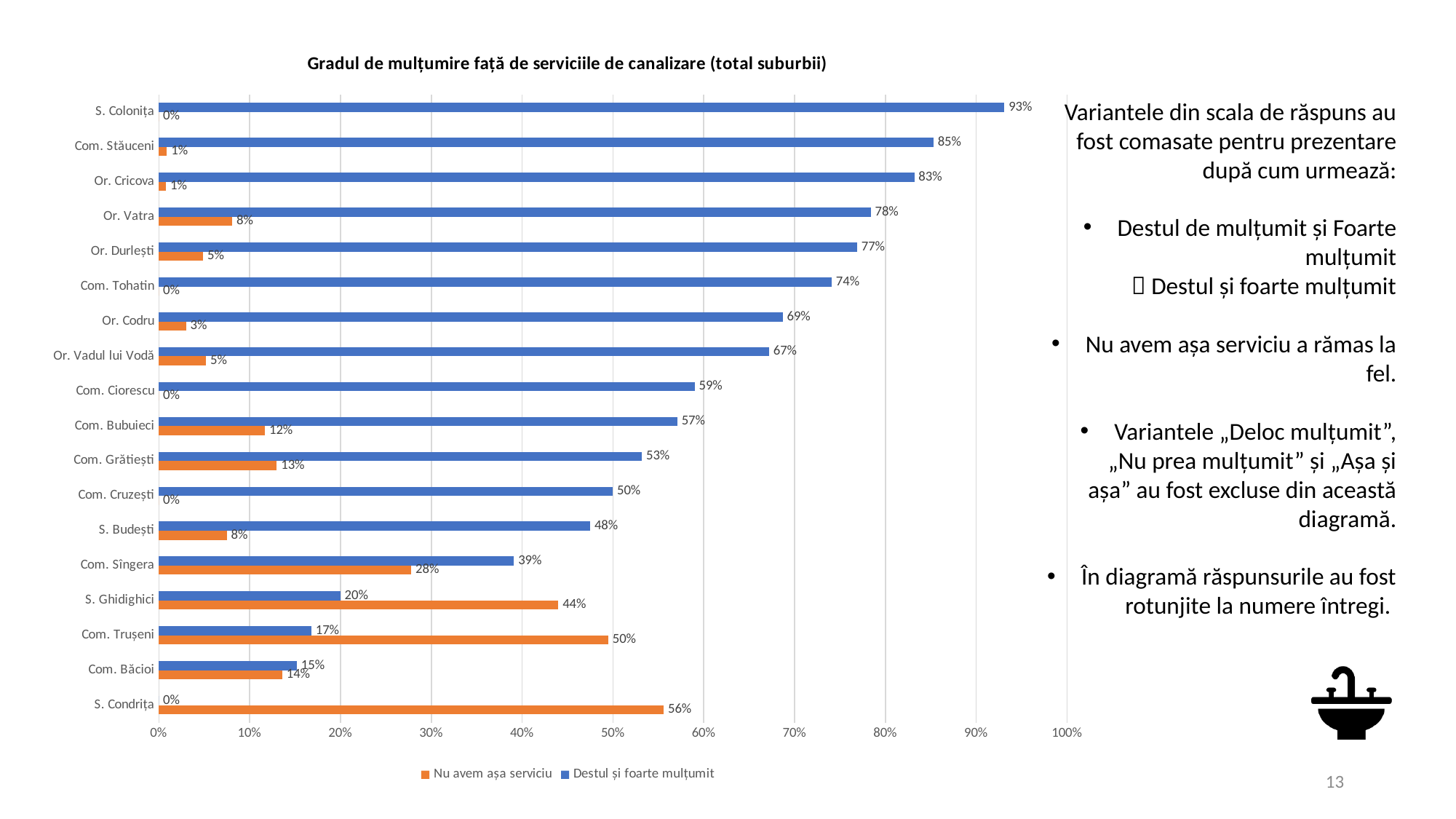
What is the value of "Destul și foarte mulțumit" for S. Colonița? 93% Which colour represents the series "Nu avem așa serviciu"? Orange How many series does the legend list? 2 What is the difference between the "Destul și foarte mulțumit" values for Com. Stăuceni and Or. Cricova? 2% Which category has the lowest value for "Destul și foarte mulțumit"? S. Condrița What is the title of the chart? Gradul de mulțumire față de serviciile de canalizare (total suburbii) Which category has the highest value for "Nu avem așa serviciu"? S. Condrița Which is larger for S. Ghidighici: "Nu avem așa serviciu" or "Destul și foarte mulțumit"? Nu avem așa serviciu What is the value of "Destul și foarte mulțumit" for Com. Sîngera? 39% What is the value of "Nu avem așa serviciu" for Com. Trușeni? 50% What kind of chart is shown on the slide? Bar chart How many categories (localities) are shown on the chart? 18